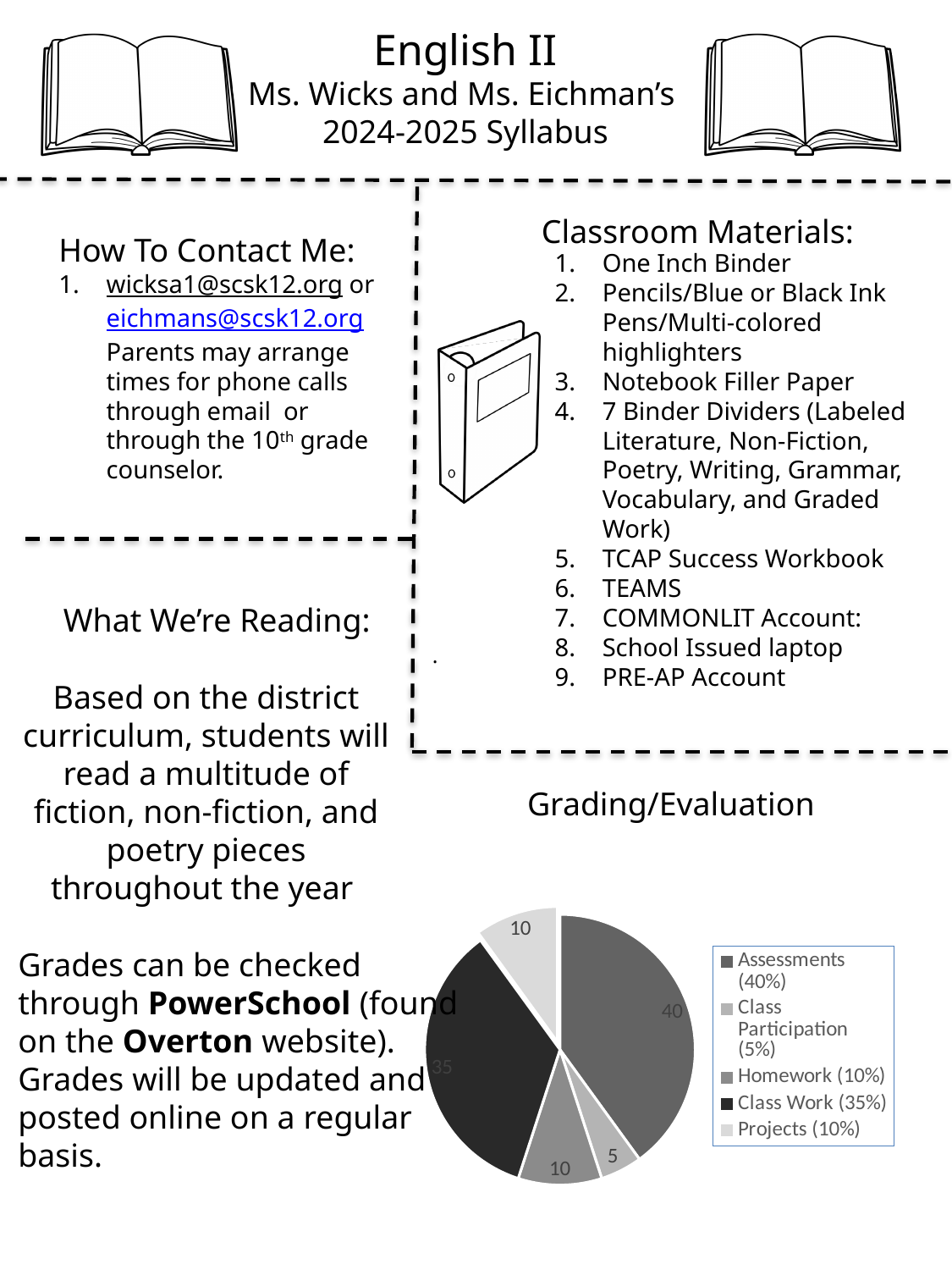
How many slices does the Grading/Evaluation pie chart have? 5 What is the data label on the Class Participation slice of the Grading/Evaluation pie chart? 5 Which category has the smallest slice in the Grading/Evaluation pie chart? Class Participation Which category has the largest slice in the Grading/Evaluation pie chart? Assessments What is the data label on the Class Work slice of the Grading/Evaluation pie chart? 35 What is the data label on the Assessments slice of the Grading/Evaluation pie chart? 40 In the Grading/Evaluation pie chart, which is larger: Homework or Class Participation? Homework What is the title shown above the pie chart on the slide? Grading/Evaluation What kind of chart is shown under Grading/Evaluation? pie chart How many entries does the legend of the Grading/Evaluation pie chart list? 5 In the Grading/Evaluation pie chart, what is the difference between the Assessments value and the Class Work value? 5 What percentage does the legend of the Grading/Evaluation pie chart give for Projects? 10%